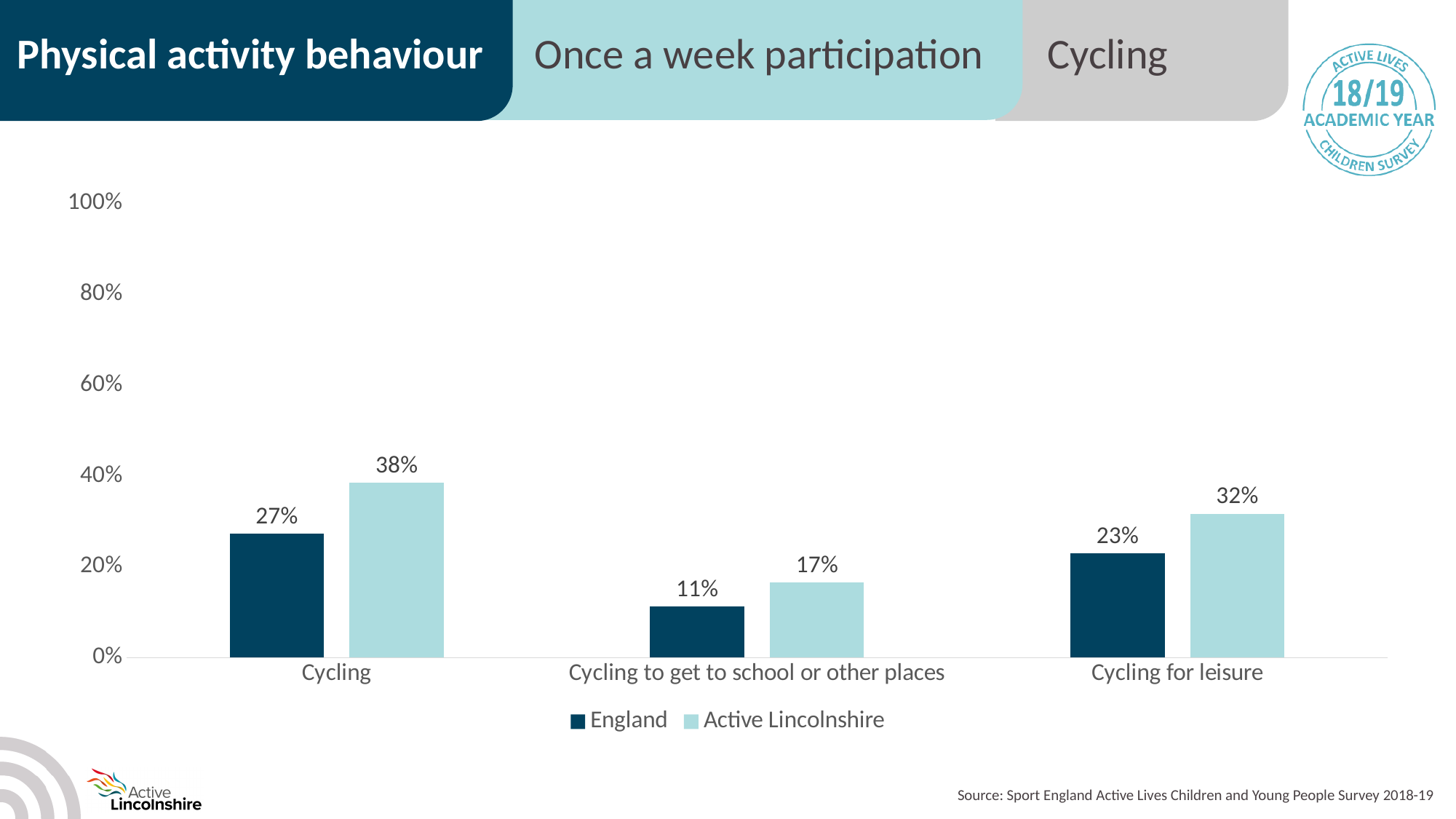
What is the England value for Cycling for leisure? 23% Which category has the highest Active Lincolnshire value? Cycling What is the difference between the Active Lincolnshire and England values for Cycling for leisure? 9% Which category has the lowest England value? Cycling to get to school or other places How many categories are shown on the x axis? 3 Which is larger for Cycling to get to school or other places: England or Active Lincolnshire? Active Lincolnshire Which series is shown in dark blue in the legend? England What is the England value for Cycling? 27% What is the Active Lincolnshire value for Cycling to get to school or other places? 17% How many series does the legend list? 2 What kind of chart is shown on the slide? bar chart Is the Active Lincolnshire value for Cycling greater or less than 40%? less